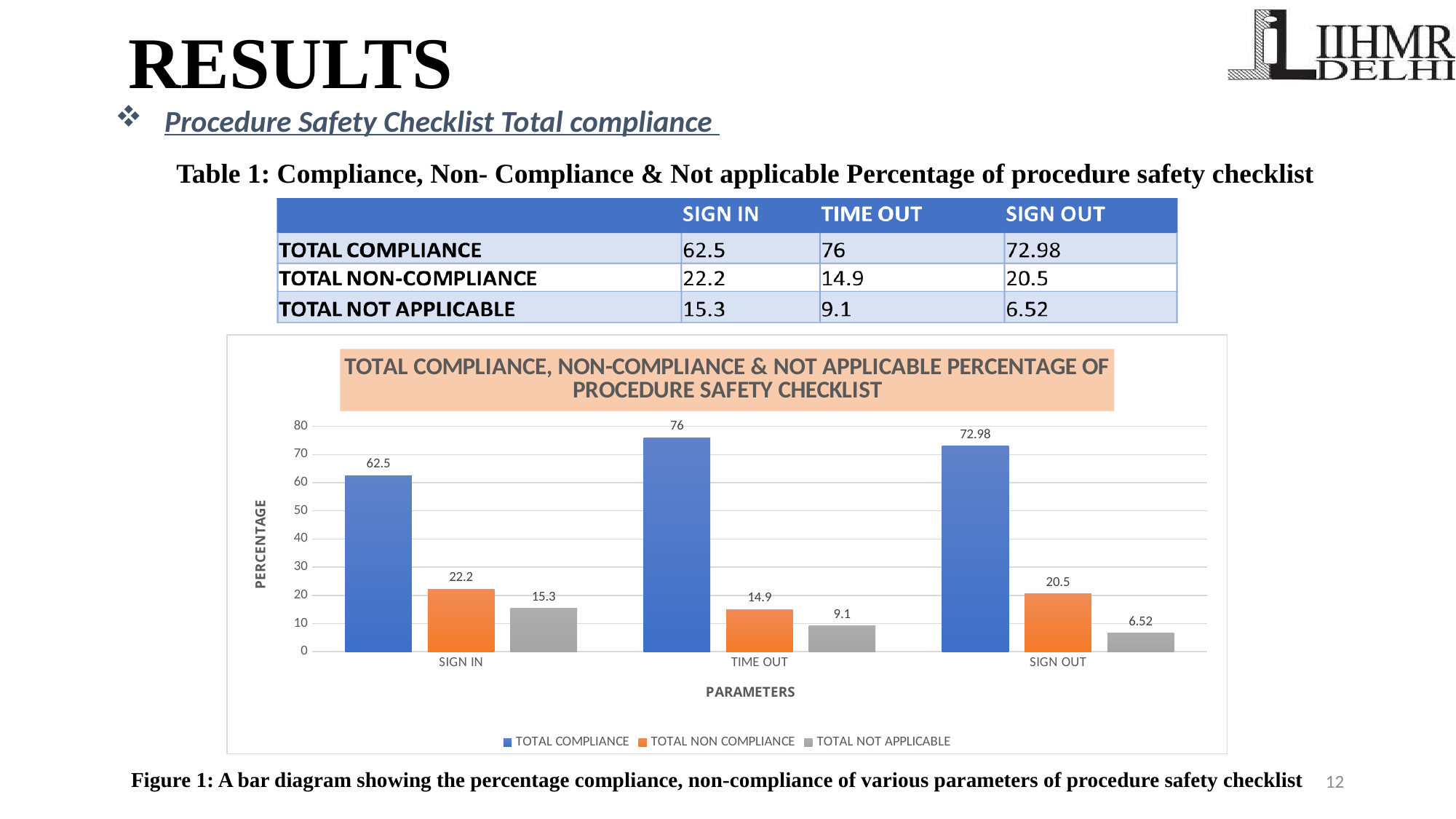
What is the difference between the TOTAL COMPLIANCE values for TIME OUT and SIGN IN? 13.5 Which parameter has the lowest TOTAL NOT APPLICABLE value? SIGN OUT Is the TOTAL COMPLIANCE value for SIGN OUT greater or less than 70? greater What is the TOTAL COMPLIANCE value for TIME OUT? 76 What is the TOTAL NOT APPLICABLE value for SIGN OUT? 6.52 What kind of chart is shown on the slide? bar chart What is the label of the vertical axis of the chart? PERCENTAGE Which is larger: TOTAL NON COMPLIANCE for SIGN OUT or TOTAL NON COMPLIANCE for TIME OUT? SIGN OUT How many parameters are shown on the x axis of the chart? 3 Which parameter has the highest TOTAL COMPLIANCE value? TIME OUT How many series does the chart legend list? 3 What is the TOTAL NON COMPLIANCE value for SIGN IN? 22.2